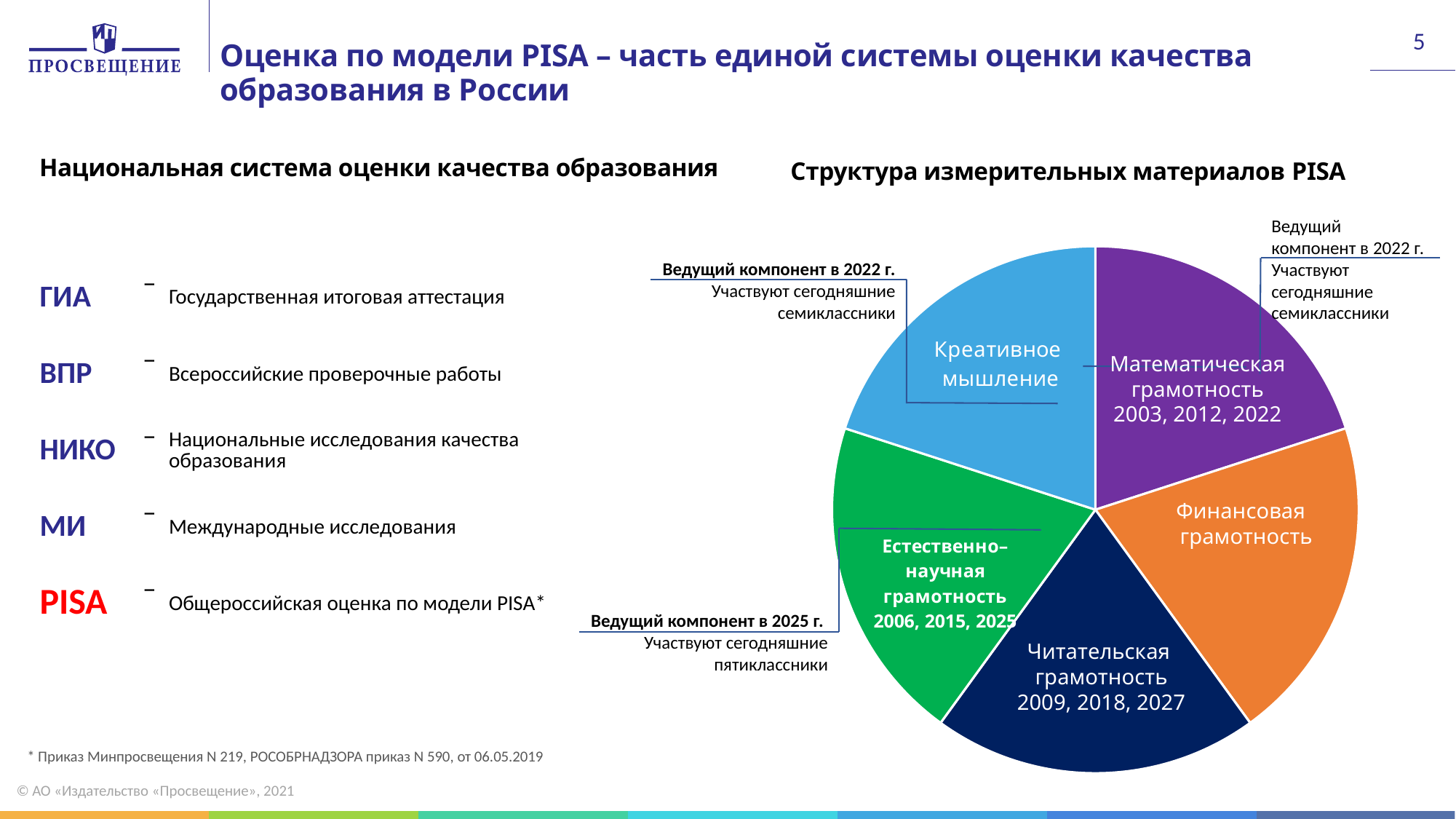
In the pie chart, which slice is coloured purple? Математическая грамотность How many slices does the pie chart "Структура измерительных материалов PISA" have? 5 What kind of chart is shown under the heading "Структура измерительных материалов PISA"? pie chart In the pie chart, which years are listed on the "Естественно-научная грамотность" slice? 2006, 2015, 2025 What is the title of the pie chart on the right side of the slide? Структура измерительных материалов PISA In the pie chart, which slice is coloured dark navy blue? Читательская грамотность In the pie chart, which slice is labelled as the leading component in 2025 ("Ведущий компонент в 2025 г.")? Естественно-научная грамотность In the pie chart, which years are listed on the "Математическая грамотность" slice? 2003, 2012, 2022 In the pie chart, which slice is coloured light blue? Креативное мышление In the pie chart, which years are listed on the "Читательская грамотность" slice? 2009, 2018, 2027 In the pie chart, what colour is the "Финансовая грамотность" slice? orange